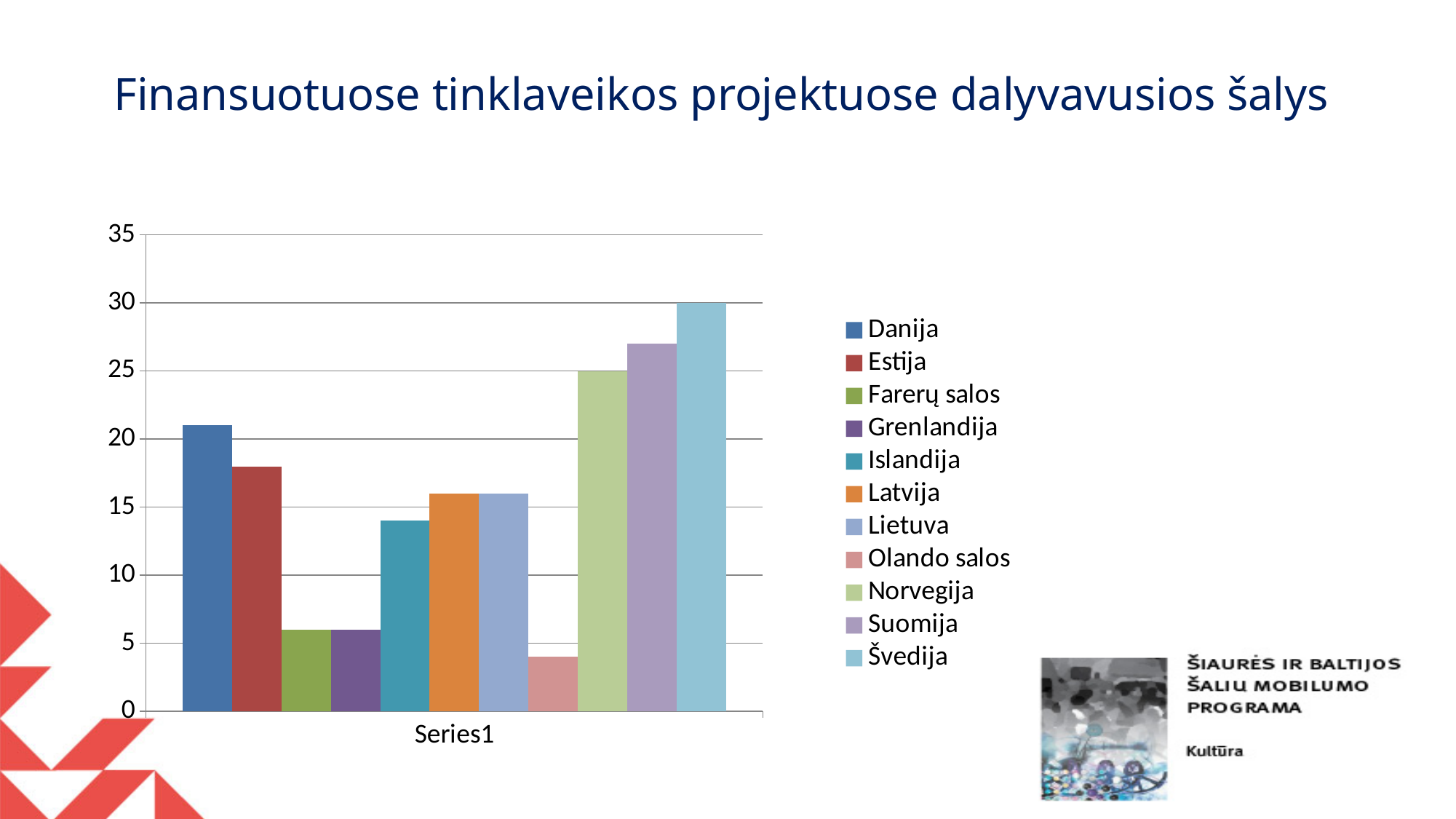
Is the value for Danija greater or less than 20? greater Which country has the lowest bar in the chart? Olando salos What is the value for Norvegija? 25 What is the title of the slide containing the chart? Finansuotuose tinklaveikos projektuose dalyvavusios šalys Is the value for Islandija greater or less than 15? less How many entries does the chart legend list? 11 What is the difference between the values for Švedija and Norvegija? 5 How many bars are plotted in the chart? 11 Which country has the highest bar in the chart? Švedija What type of chart is shown on the slide? bar chart What is the value for Švedija? 30 Which has the larger value, Danija or Estija? Danija